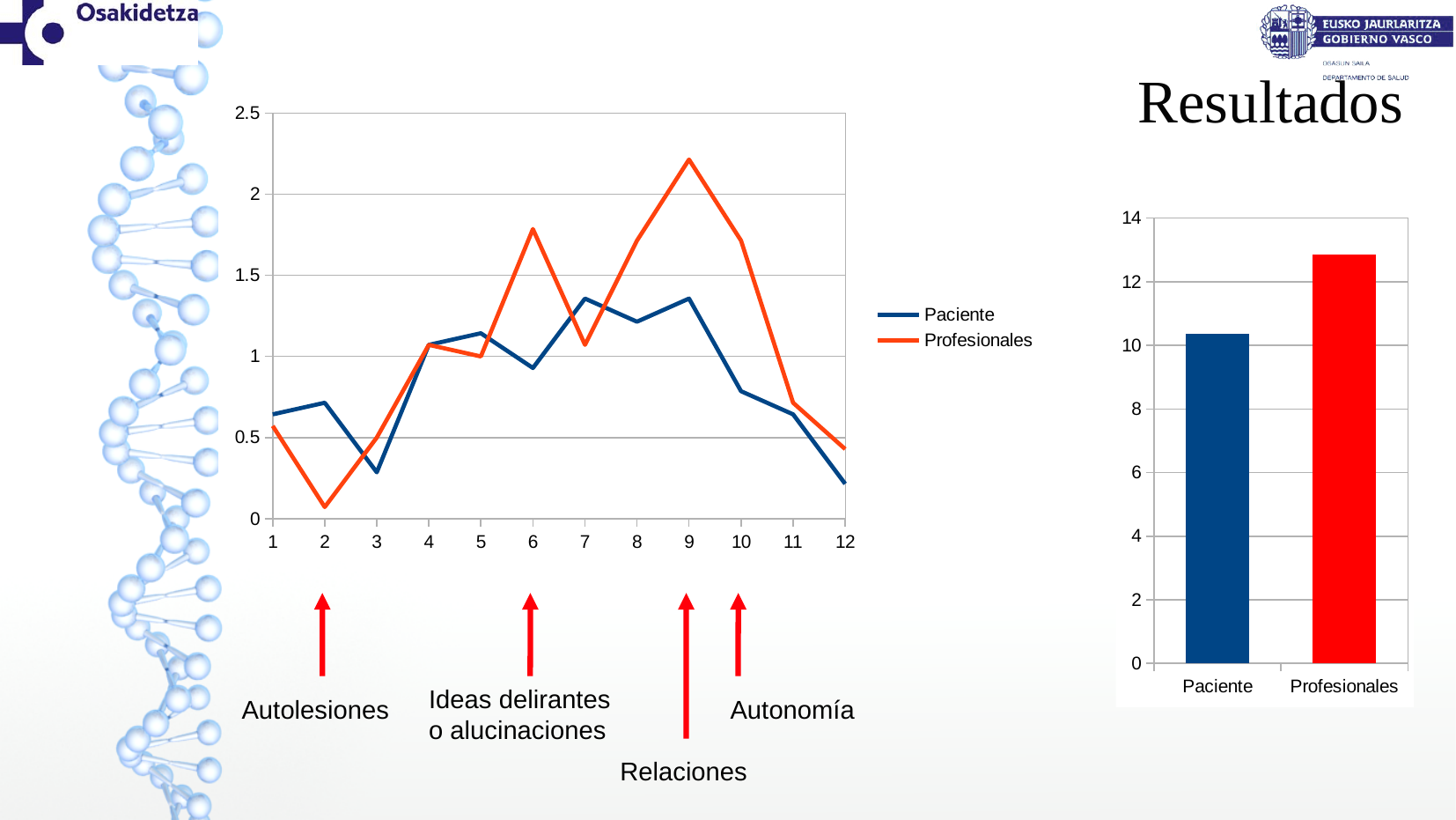
In the line chart on the left, at point 2, which series has the larger value, Paciente or Profesionales? Paciente What kind of chart is the chart on the right of the slide? bar chart In the line chart on the left, at which x-axis point does the Profesionales series reach its lowest value? 2 In the line chart on the left, how many points are there along the x axis? 12 In the line chart on the left, at point 9, which series has the larger value, Paciente or Profesionales? Profesionales In the bar chart on the right, which category has the higher bar, Paciente or Profesionales? Profesionales In the line chart on the left, how many series does the legend list? 2 In the line chart on the left, is the Profesionales value at point 2 greater or less than 0.5? less In the bar chart on the right, is the value for Paciente greater or less than 10? greater In the line chart on the left, what are the names of the two series in the legend? Paciente and Profesionales In the line chart on the left, is the Profesionales value at point 9 greater or less than 2? greater In the line chart on the left, at which x-axis point does the Profesionales series reach its highest value? 9